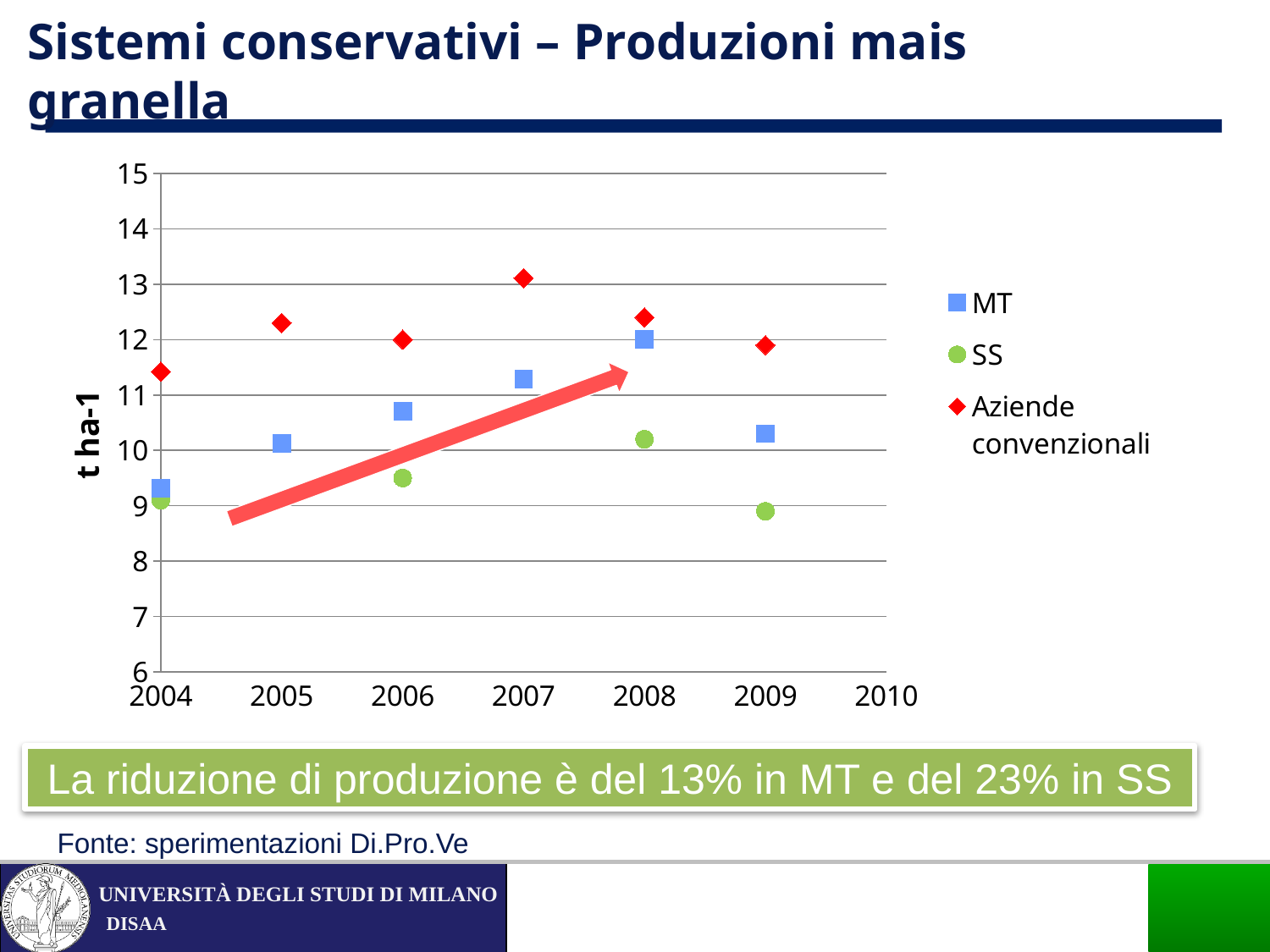
In which year does the Aziende convenzionali series reach its highest value? 2007 What kind of chart is shown on the slide? scatter chart Is the value for MT in 2004 greater or less than 10? less Is the value for SS in 2006 greater or less than 10? less In 2008, which is larger: the MT value or the SS value? MT What are the three series named in the legend? MT, SS, Aziende convenzionali Is the value for Aziende convenzionali in 2005 greater or less than 12? greater Do the MT values rise or fall from 2004 to 2008? rise What is the label on the vertical axis? t ha-1 How many series does the legend list? 3 Which series has the highest value in 2007? Aziende convenzionali